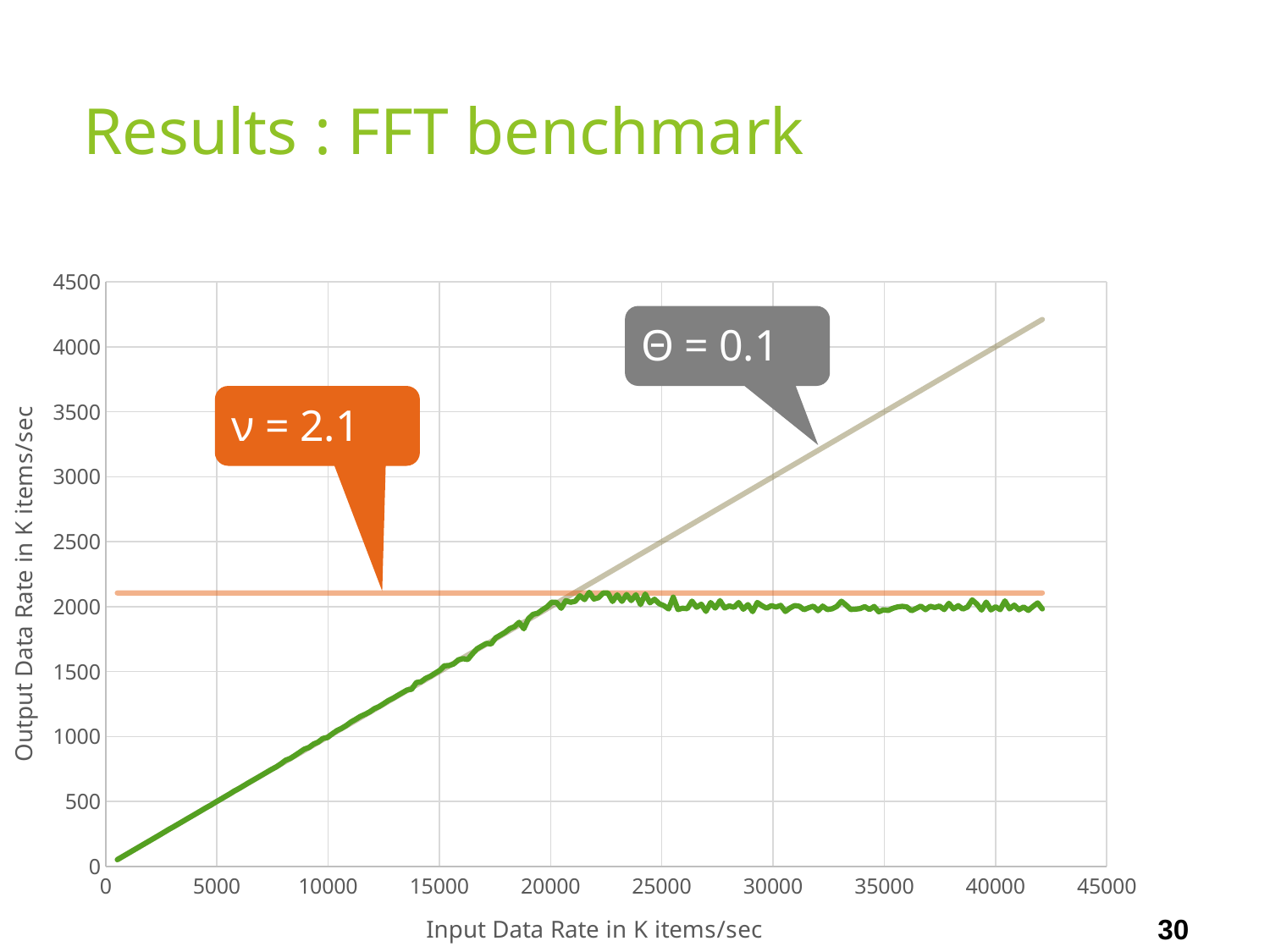
How many lines are plotted on the chart? 3 What is the title of the slide containing the chart? Results : FFT benchmark What is the highest tick value shown on the y axis? 4500 What is the highest tick value shown on the x axis? 45000 Does the green line rise or stay flat as the input data rate increases from 0 to 20000? rise Is the value of the green line at an input data rate of 10000 greater or less than 1500? less At an input data rate of 40000, which line has the larger value: the green line or the beige diagonal line? the beige diagonal line What kind of chart is shown on the slide? line chart What is the label of the y axis? Output Data Rate in K items/sec Is the value of the green line at an input data rate of 30000 greater or less than 2500? less What is the label of the x axis? Input Data Rate in K items/sec Is the value of the beige diagonal line at an input data rate of 40000 greater or less than 3500? greater